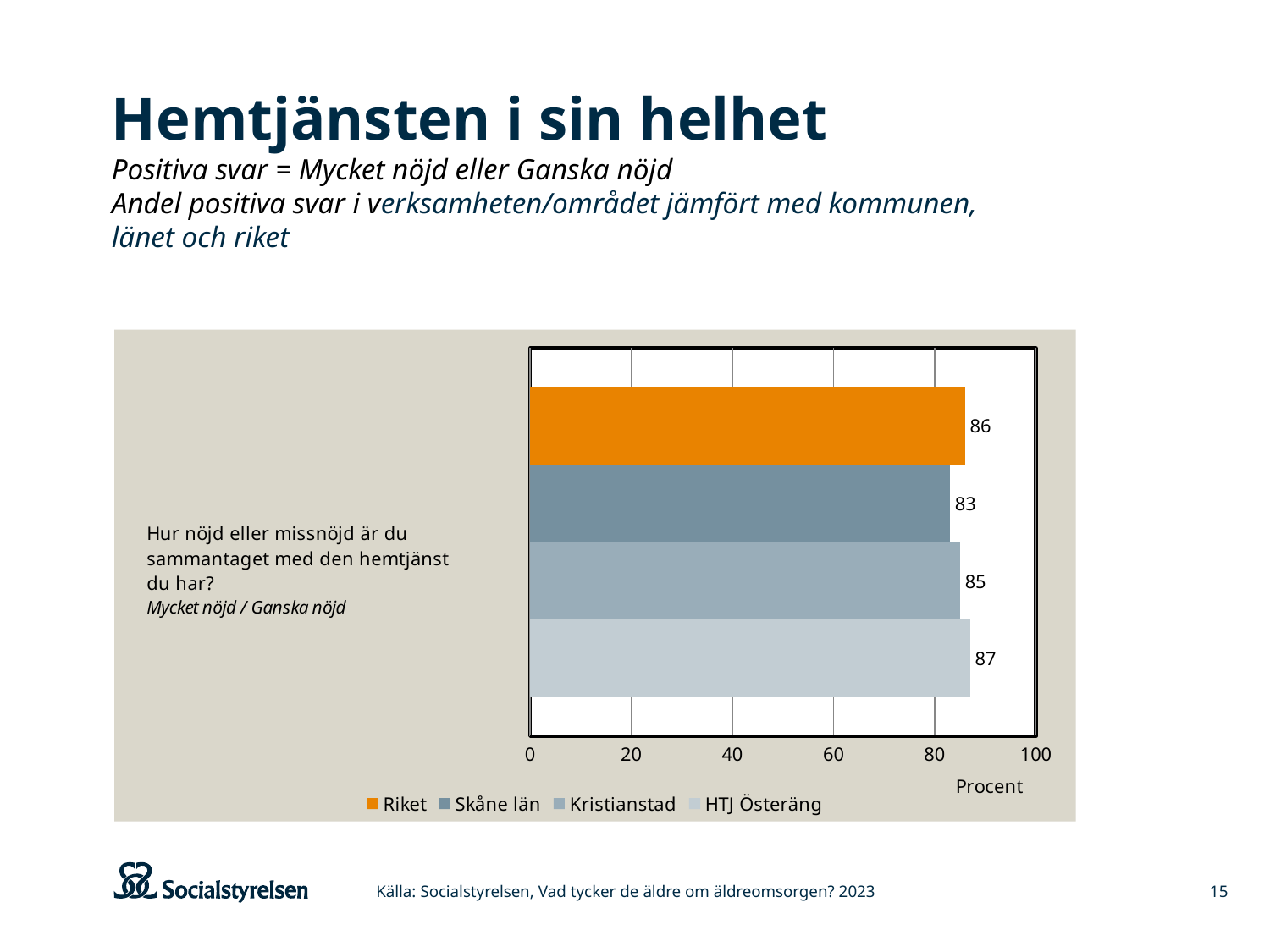
What is the difference between the values for Riket and Kristianstad? 1 What is the label of the x axis? Procent Which series has the lowest value? Skåne län What is the value for Kristianstad? 85 What is the value for HTJ Österäng? 87 How many series does the legend list? 4 What is the value for Riket? 86 What kind of chart is shown on the slide? Bar chart What is the value for Skåne län? 83 What is the difference between the values for HTJ Österäng and Skåne län? 4 Which series has the highest value? HTJ Österäng Which is larger, the value for Riket or the value for Skåne län? Riket